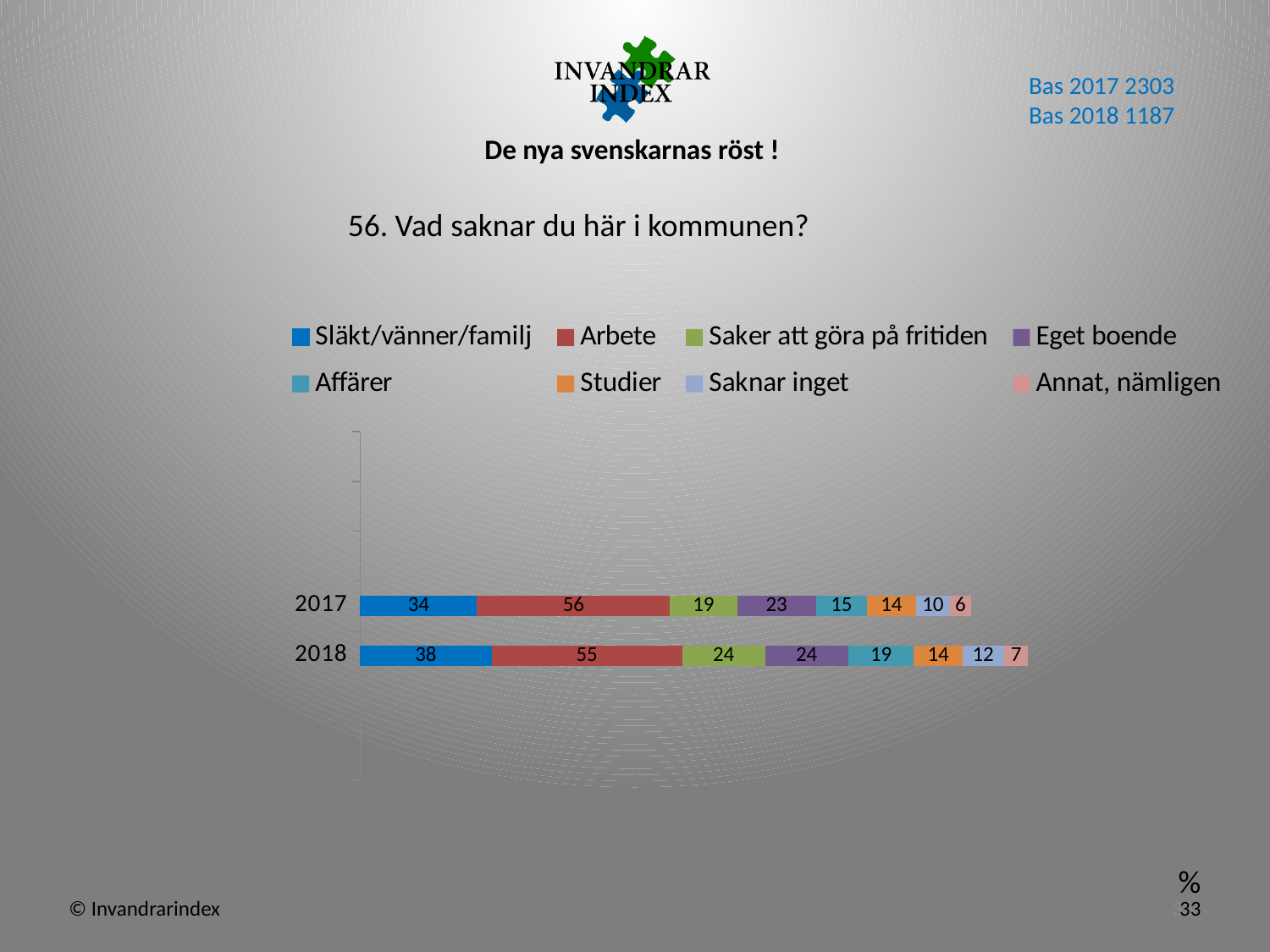
What is the value for Affärer in 2018? 19 Which is larger, the Eget boende value for 2017 or for 2018? 2018 Which series has the lowest value in 2017? Annat, nämligen What is the value for Saker att göra på fritiden in 2018? 24 What is the difference between the Släkt/vänner/familj values for 2018 and 2017? 4 What is the value for Arbete in 2017? 56 How many series does the legend list? 8 How many categories (years) are plotted on the chart? 2 What is the total of the stacked bar for 2018? 193 Which series has the highest value in 2018? Arbete What kind of chart is shown on the slide? Stacked bar chart What is the value for Annat, nämligen in 2017? 6